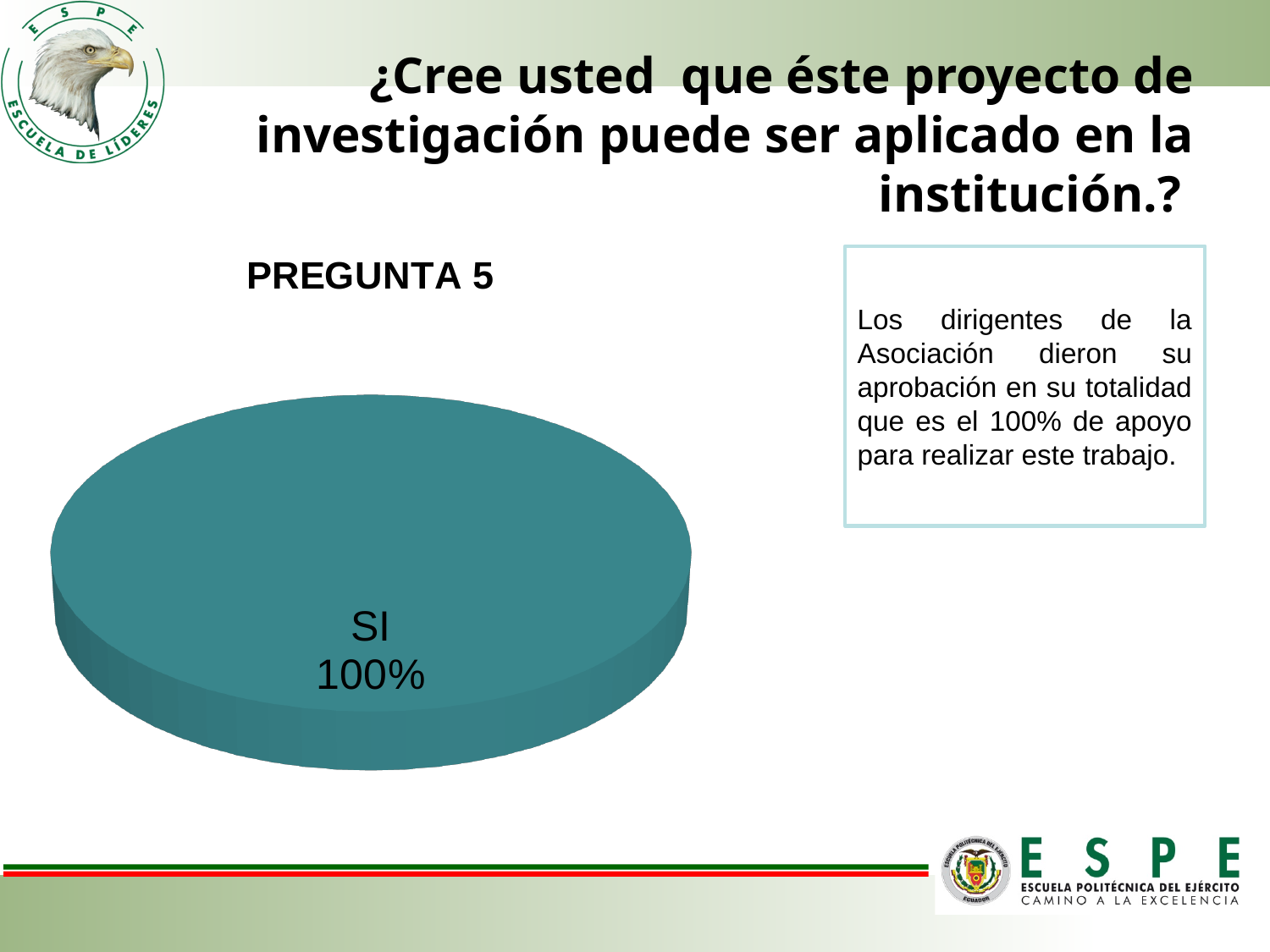
Which category is the largest in the pie chart? SI How many slices does the pie chart have? 1 What is the title shown above the pie chart? PREGUNTA 5 What kind of chart is shown on the slide? pie chart What share of the pie does the SI slice represent? 100% What is the label of the only slice in the pie chart? SI What is the value shown for the SI category in the pie chart? 100% Is the value for SI greater or less than 50%? greater